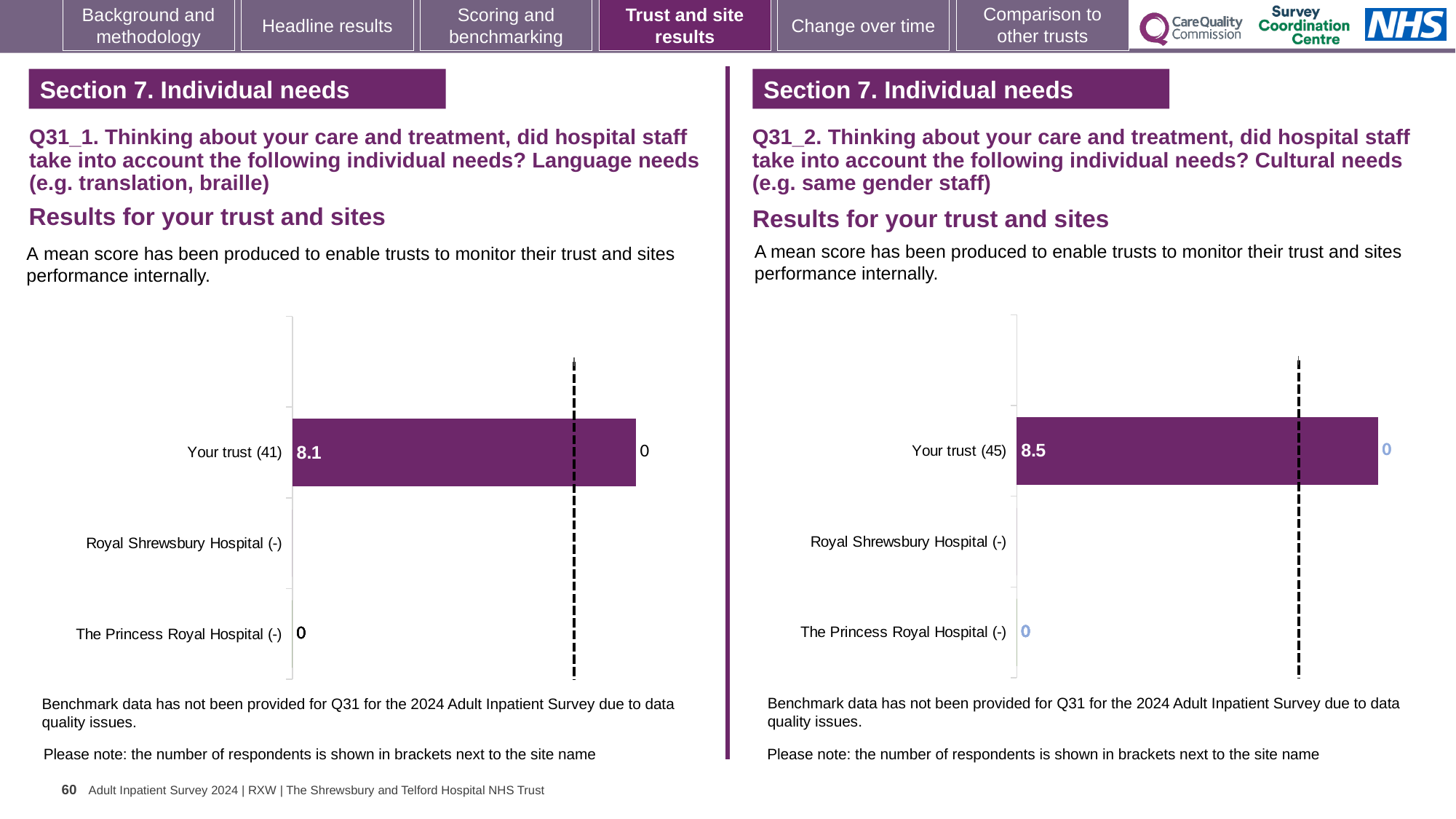
On the right chart (Q31_2, Cultural needs), what is the mean score for Your trust? 8.5 How many categories are listed on the y axis of the right chart (Q31_2, Cultural needs)? 3 Which is larger: the Your trust score on the left chart (Q31_1, Language needs) or the Your trust score on the right chart (Q31_2, Cultural needs)? Right chart (Q31_2, Cultural needs) How many categories are listed on the y axis of the left chart (Q31_1, Language needs)? 3 On the right chart (Q31_2, Cultural needs), which category has the highest mean score? Your trust (45) On the right chart (Q31_2, Cultural needs), how many respondents are shown in brackets next to Your trust? 45 On the left chart (Q31_1, Language needs), what is the mean score for Your trust? 8.1 What kind of chart is used on the left chart (Q31_1, Language needs)? Bar chart On the left chart (Q31_1, Language needs), how many respondents are shown in brackets next to Your trust? 41 On the left chart (Q31_1, Language needs), which category has the highest mean score? Your trust (41) What is the difference between the Your trust score on the right chart (Q31_2, Cultural needs) and the Your trust score on the left chart (Q31_1, Language needs)? 0.4